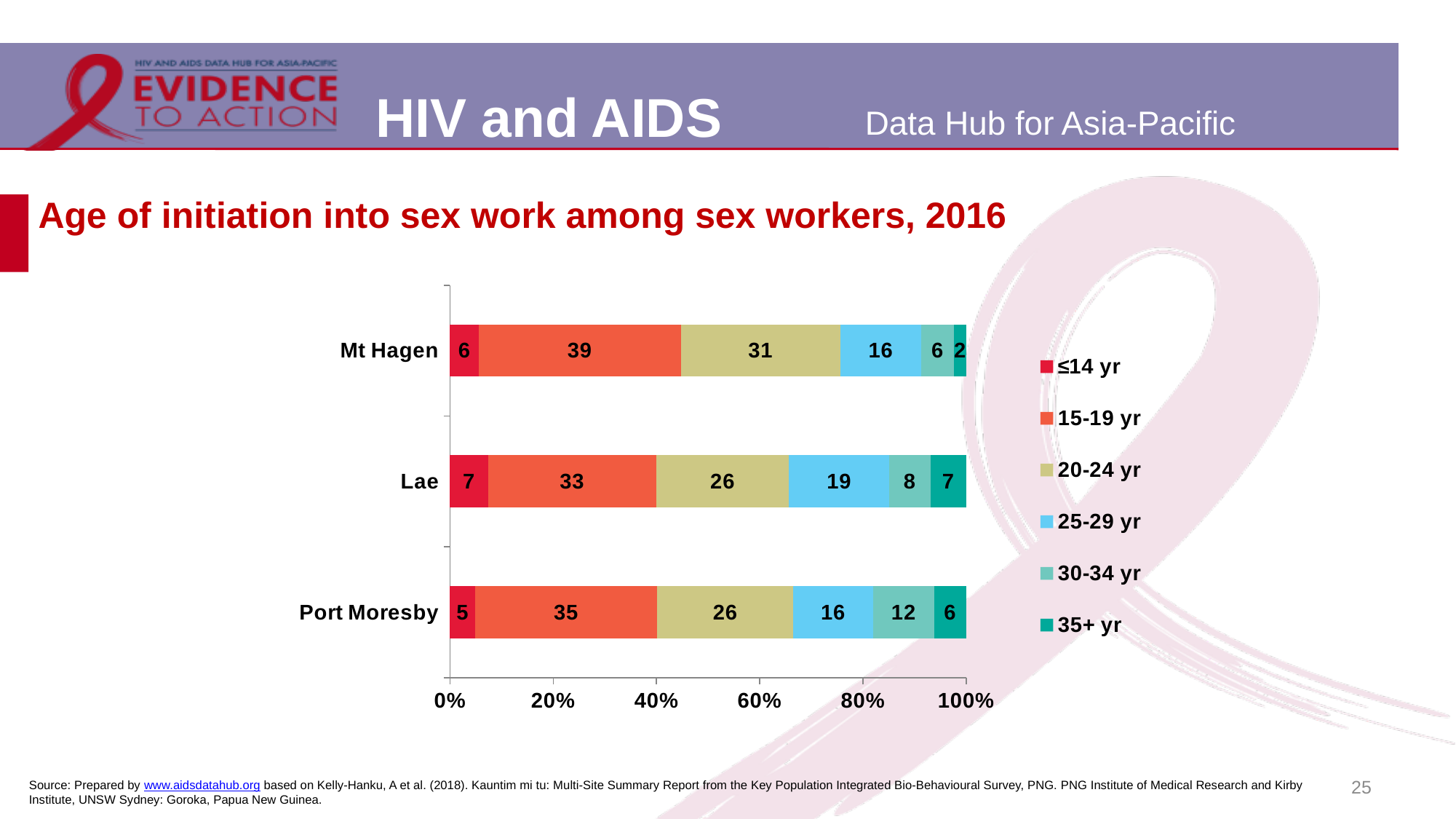
What is the title of the chart? Age of initiation into sex work among sex workers, 2016 What is the value for the 15-19 yr group in Mt Hagen? 39 Which city has the highest value for the 15-19 yr group? Mt Hagen What is the value for the 35+ yr group in Mt Hagen? 2 How many cities are shown on the chart? 3 What kind of chart is shown on the slide? Stacked bar chart Which city has the lowest value for the ≤14 yr group? Port Moresby How many series does the legend list? 6 What is the value for the 25-29 yr group in Lae? 19 Which is larger: the 30-34 yr value for Port Moresby or for Lae? Port Moresby What is the value for the 30-34 yr group in Port Moresby? 12 What is the difference between the 20-24 yr values for Mt Hagen and Lae? 5